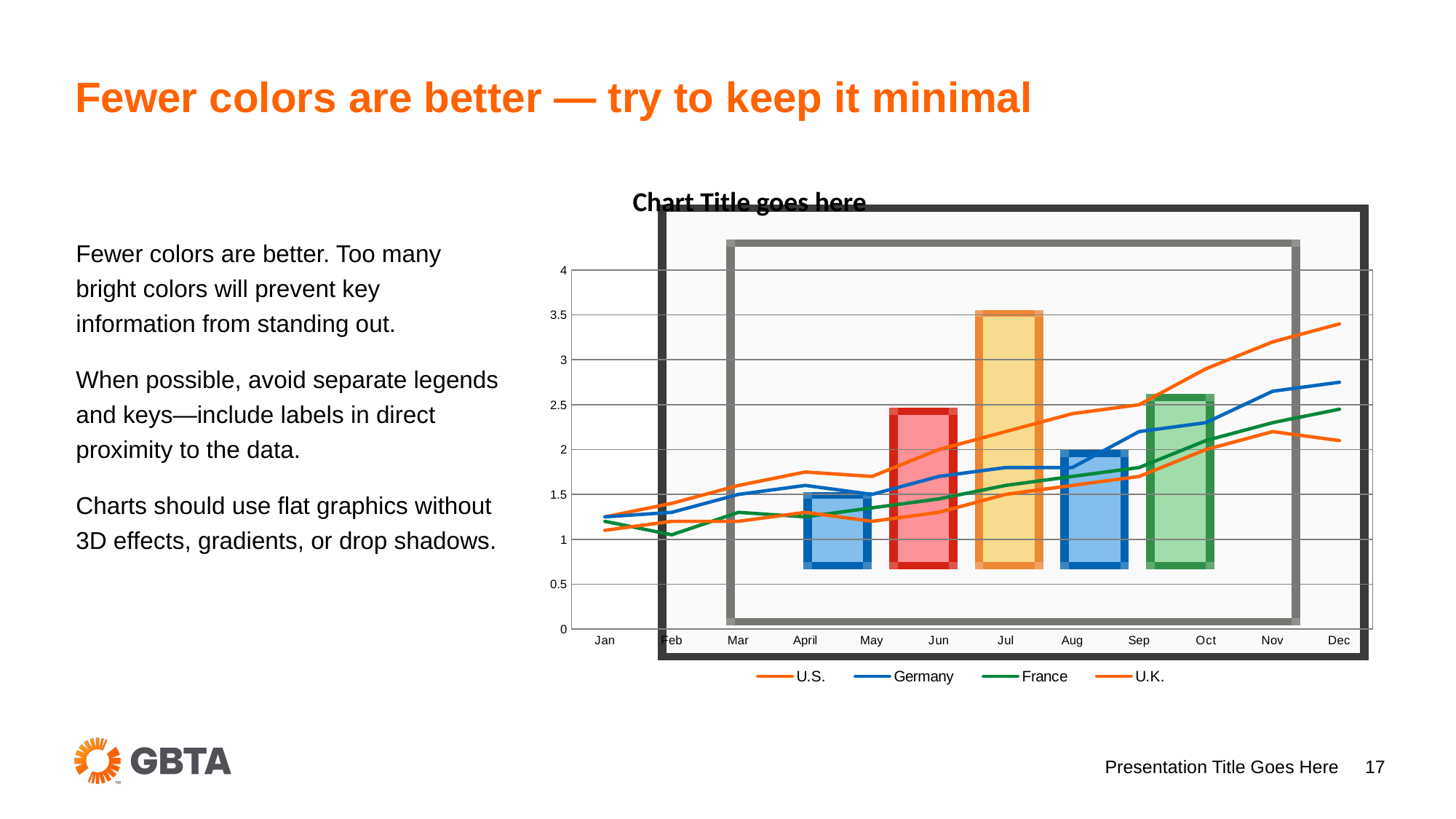
What is the title of the chart? Chart Title goes here Is the value for France in Dec greater or less than 2? greater Is the value for Germany in Jan greater or less than 1.5? less How many series does the chart legend list? 4 Does the Germany line generally rise or fall from Jan to Dec? rise Is the value for Germany in Dec greater or less than 2.5? greater How many months are shown along the x axis of the chart? 12 Which countries are listed in the chart legend? U.S., Germany, France, U.K. What kind of chart is shown on the slide? line chart Which is larger in Dec, the value for Germany or the value for France? Germany